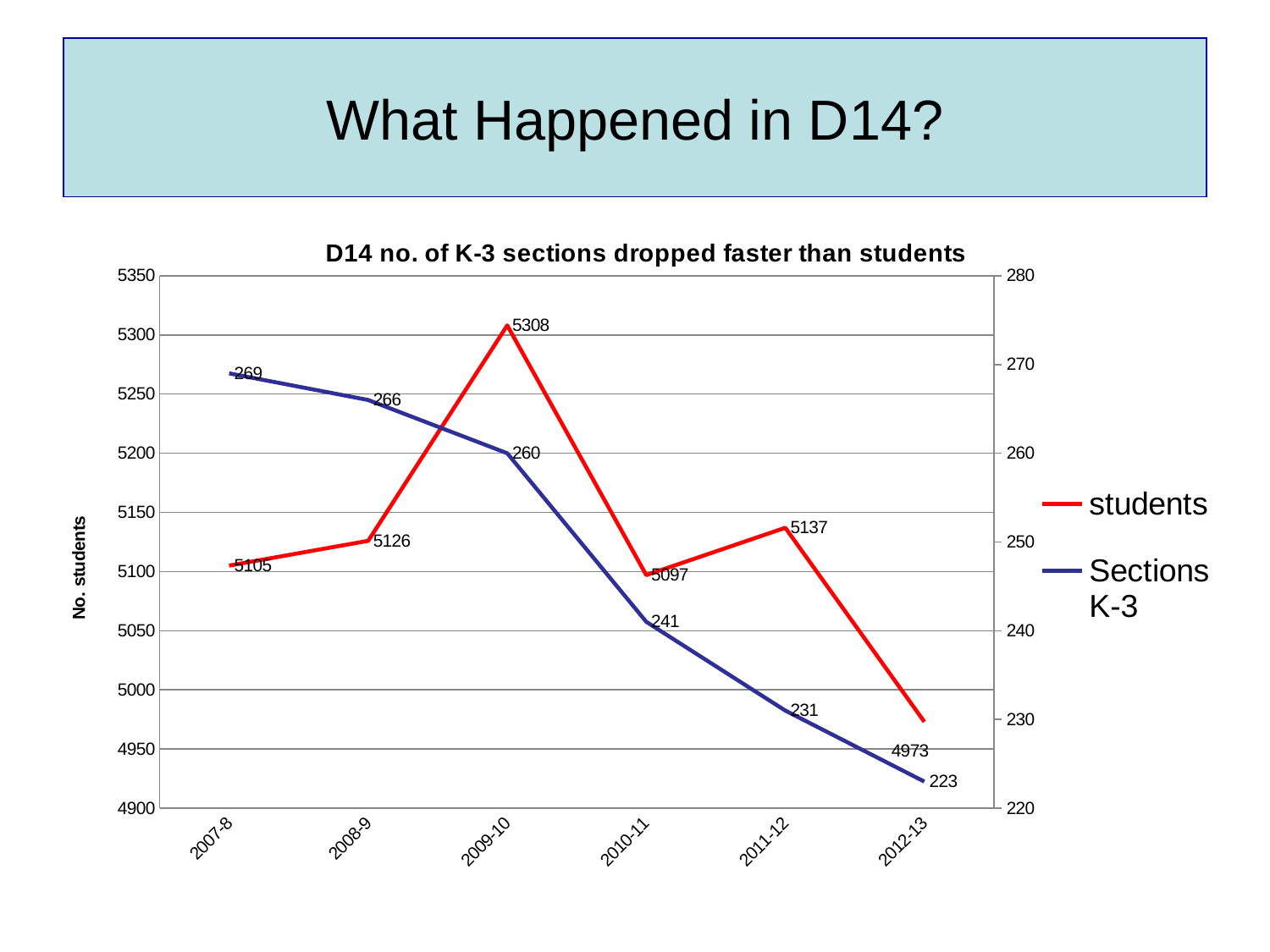
What is the number of students in 2009-10? 5308 How many series does the legend list? 2 In which year is the number of Sections K-3 lowest? 2012-13 What kind of chart is shown on the slide? line chart In which year is the number of students highest? 2009-10 Does the number of Sections K-3 rise or fall from 2007-8 to 2012-13? fall What is the number of students in 2012-13? 4973 How many years are shown on the x axis? 6 What is the number of Sections K-3 in 2010-11? 241 What is the difference in the number of students between 2009-10 and 2010-11? 211 What is the difference in the number of Sections K-3 between 2007-8 and 2012-13? 46 Which year has more students, 2008-9 or 2011-12? 2011-12